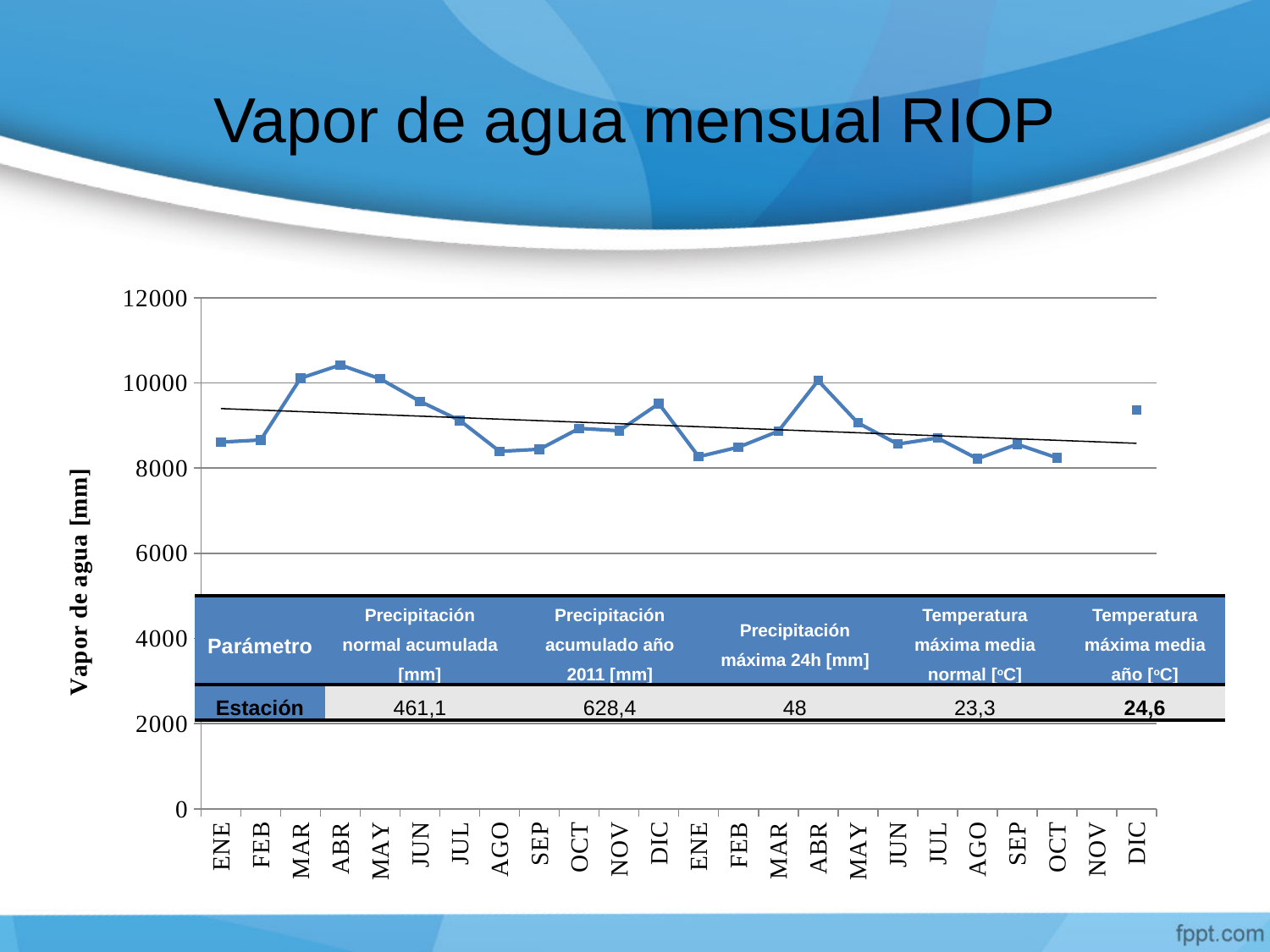
Is the value for the second DIC greater or less than 10000? less Is the value for the first AGO greater or less than 10000? less Does the straight trend line drawn across the chart rise or fall from left to right? fall Which is larger, the value for the second ABR or the value for the second MAY? ABR Is the value for the first ABR greater or less than 10000? greater What kind of chart is shown on the slide? line chart Which is larger, the value for the first ABR or the value for the first ENE? ABR How many month categories are shown along the x axis of the chart? 24 Which month has the highest water vapour value in the chart? ABR (first year) What is the label on the y axis of the chart? Vapor de agua [mm]